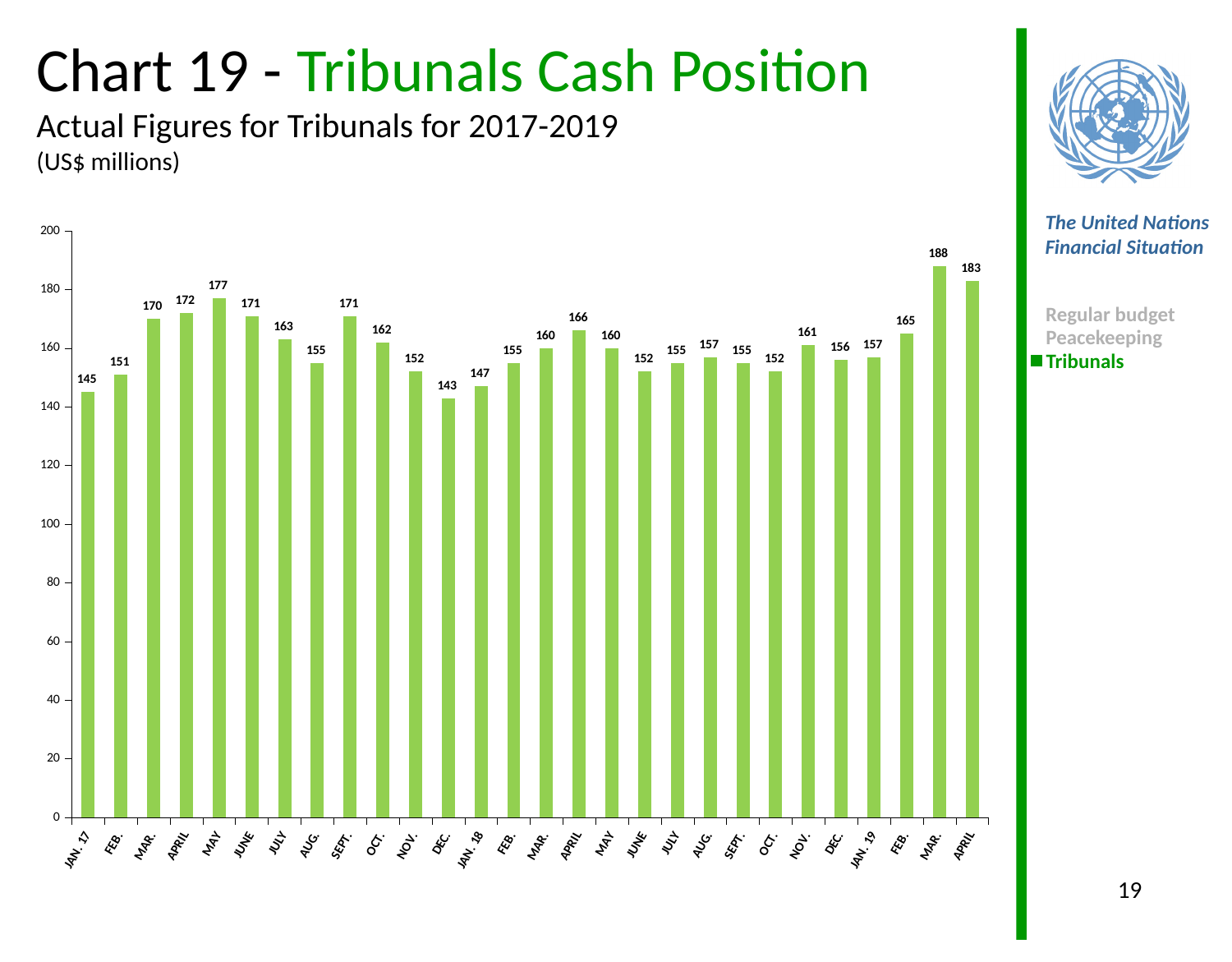
Which month has the highest value on the chart? MAR. (2019, after JAN. 19) What is the difference between the value for JAN. 19 and the value for JAN. 17? 12 Which month has the lowest value on the chart? DEC. (2017, before JAN. 18) Which is larger, the value for JAN. 18 or the value for JAN. 17? JAN. 18 What is the value for JAN. 19? 157 What kind of chart is shown on the slide? Bar chart What is the value for JAN. 17? 145 What is the value for the last bar, APRIL 2019? 183 How many bars are plotted on the chart? 28 Which legend entry is highlighted in green on the slide? Tribunals What is the value for JAN. 18? 147 What is the difference between the highest value (188) and the lowest value (143)? 45